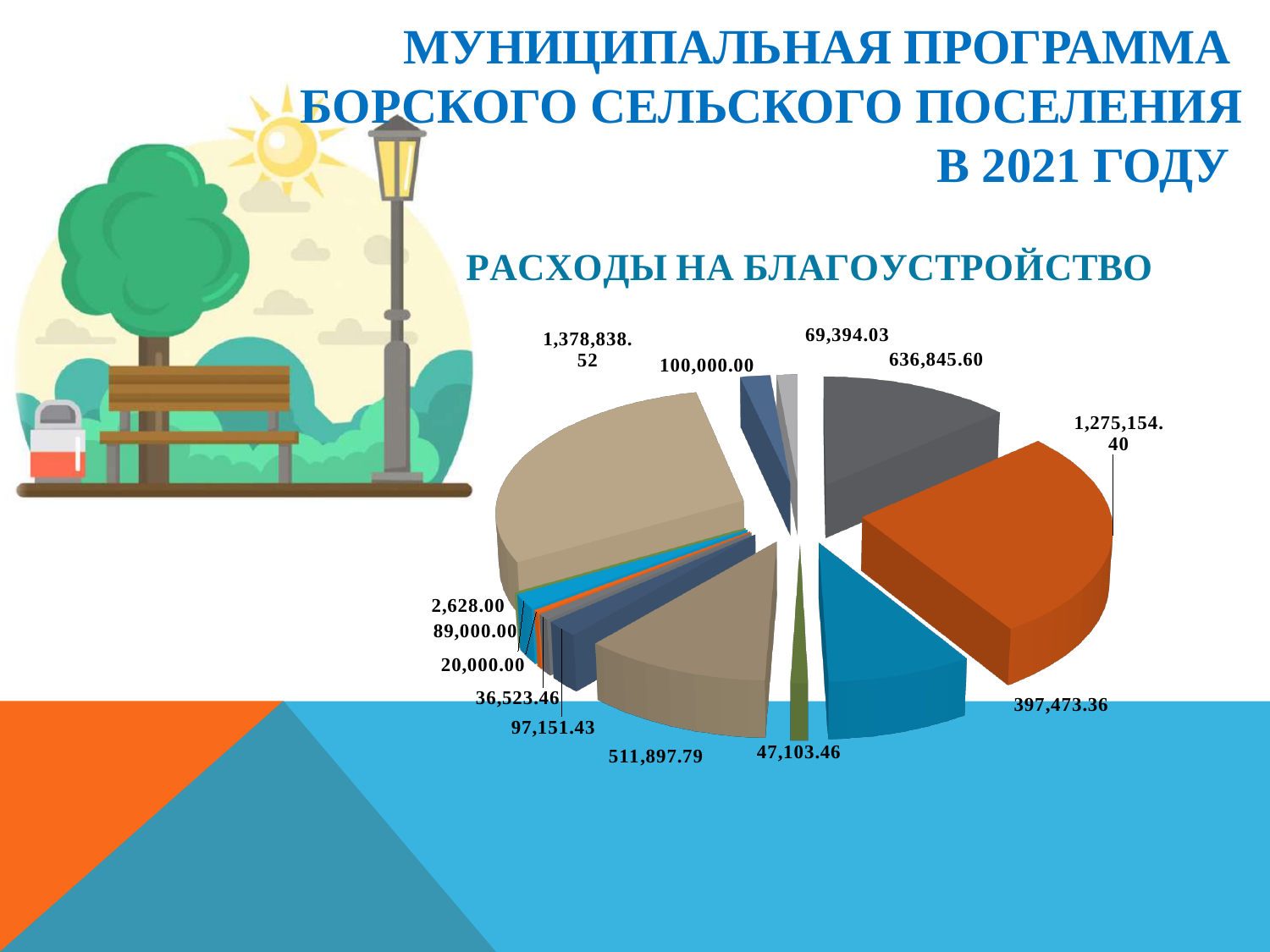
What value is labeled on the dark grey slice at the top of the pie chart? 636,845.60 How many slices does the pie chart have? 13 What is the difference between the two largest values on the pie chart, 1,378,838.52 and 1,275,154.40? 103,684.12 What is the smallest value labeled on the pie chart? 2,628.00 What value is labeled on the thin olive-green slice at the bottom of the pie chart? 47,103.46 What value is labeled on the large orange slice on the right of the pie chart? 1,275,154.40 What is the title of the chart on the slide? РАСХОДЫ НА БЛАГОУСТРОЙСТВО What is the largest value labeled on the pie chart? 1,378,838.52 Which is larger: the orange slice (1,275,154.40) or the dark grey slice (636,845.60)? the orange slice What value is labeled on the blue slice at the lower right of the pie chart? 397,473.36 What is the difference between the largest labeled value (1,378,838.52) and the smallest labeled value (2,628.00)? 1,376,210.52 What kind of chart is shown on the slide? pie chart